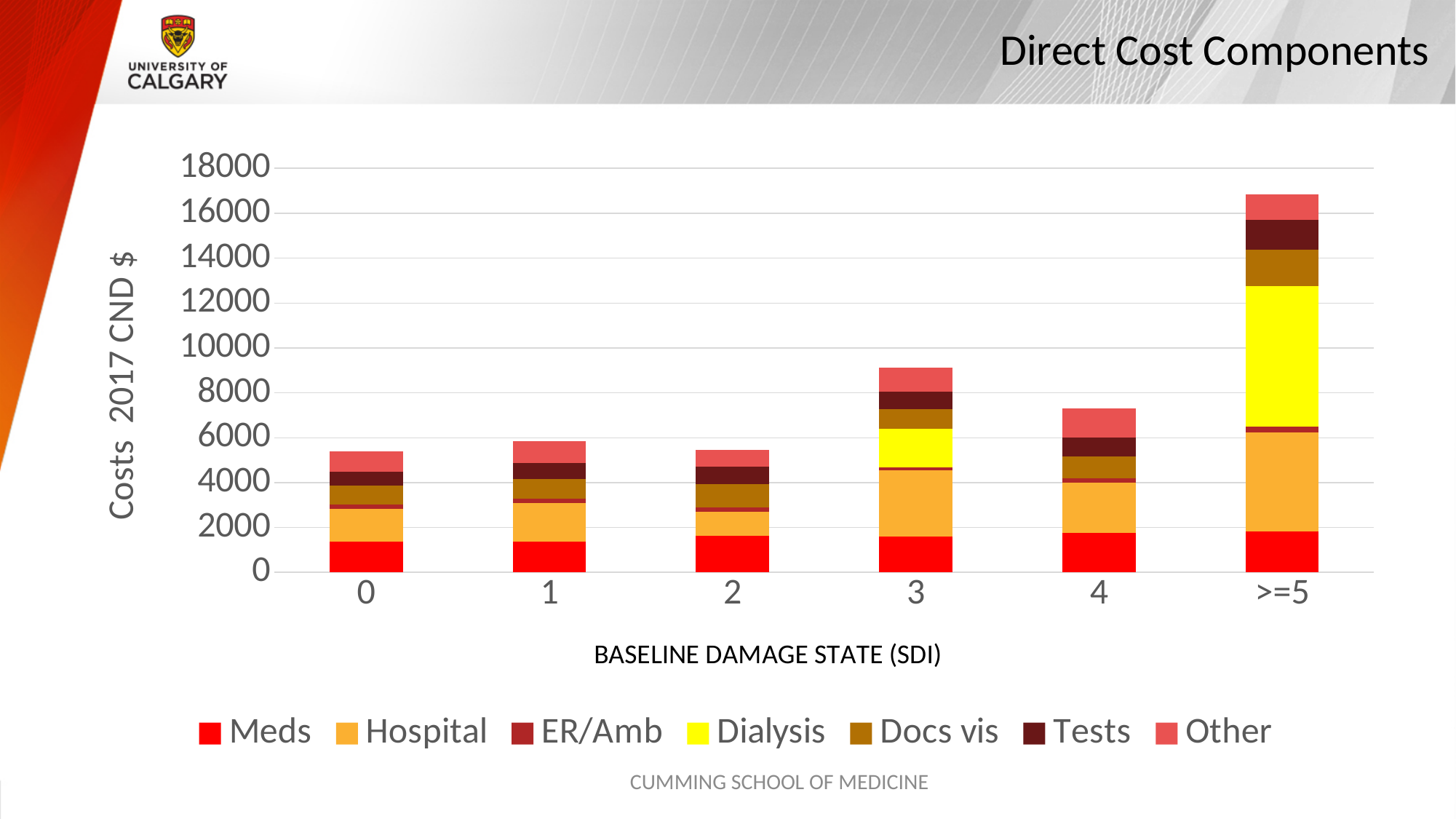
Which series is shown in yellow in the legend? Dialysis Which has a larger total direct cost, baseline damage state 3 or baseline damage state 4? 3 Is the total cost for baseline damage state 0 greater or less than 6000? less Is the total cost for baseline damage state >=5 greater or less than 16000? greater What kind of chart is shown on the slide? Stacked bar chart Is the total cost for baseline damage state 4 greater or less than 8000? less What is the label of the y axis? Costs 2017 CND $ How many series does the legend list? 7 Which baseline damage state has the highest total direct cost? >=5 How many baseline damage state categories are shown on the x axis? 6